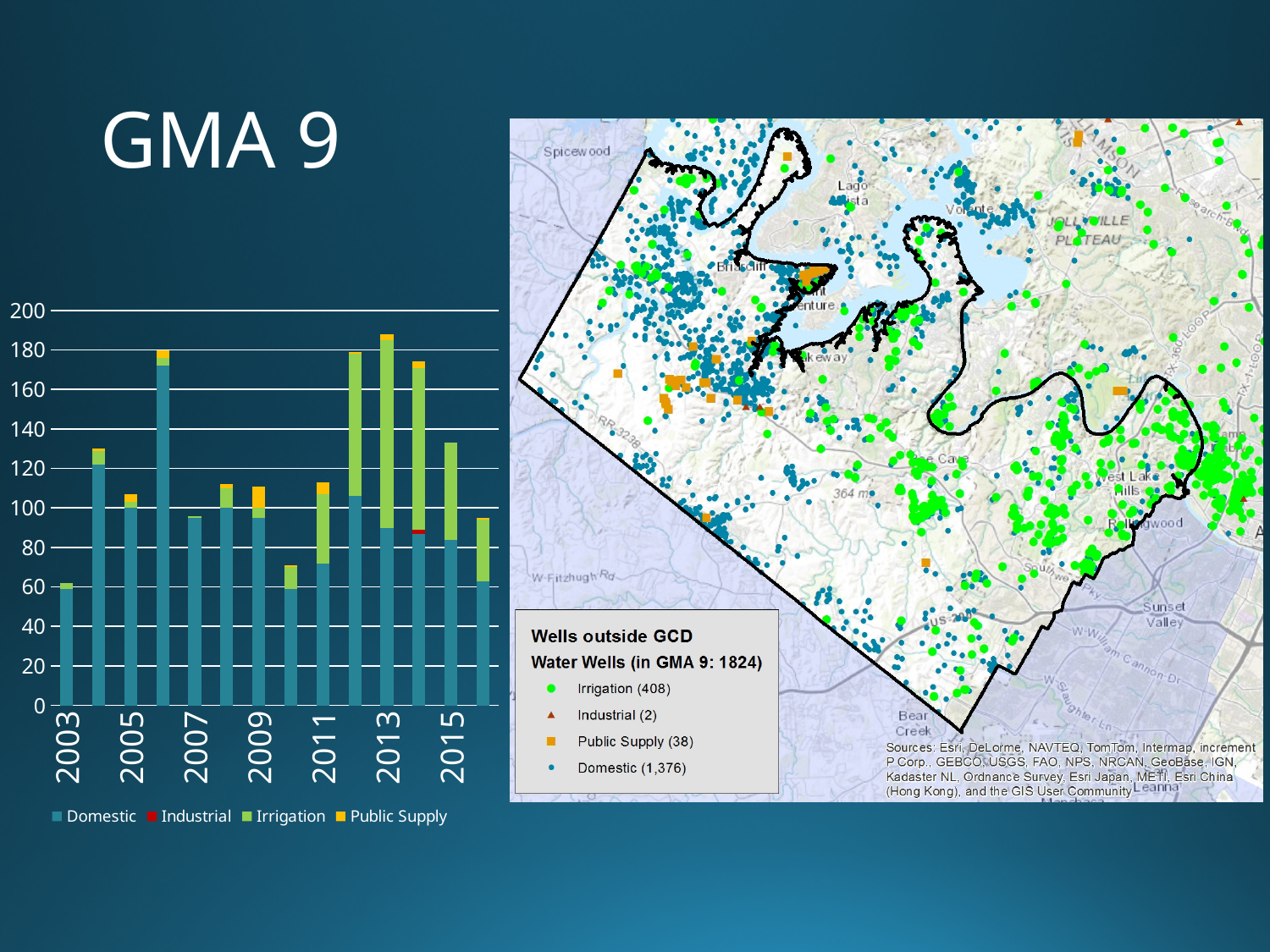
Which year has the shortest total bar in the chart? 2003 Which year has the larger total bar, 2004 or 2005? 2004 Which series in the bar chart is shown in red? Industrial Is the total value for 2010 greater or less than 80? less Which year has the larger total bar, 2012 or 2010? 2012 Is the total value for 2003 greater or less than 80? less How many years (bars) are shown in the bar chart? 14 Is the total value for 2012 greater or less than 160? greater Which year has the tallest total bar in the chart? 2013 What kind of chart is shown on the left of the slide? Stacked bar chart How many series does the legend of the bar chart list? 4